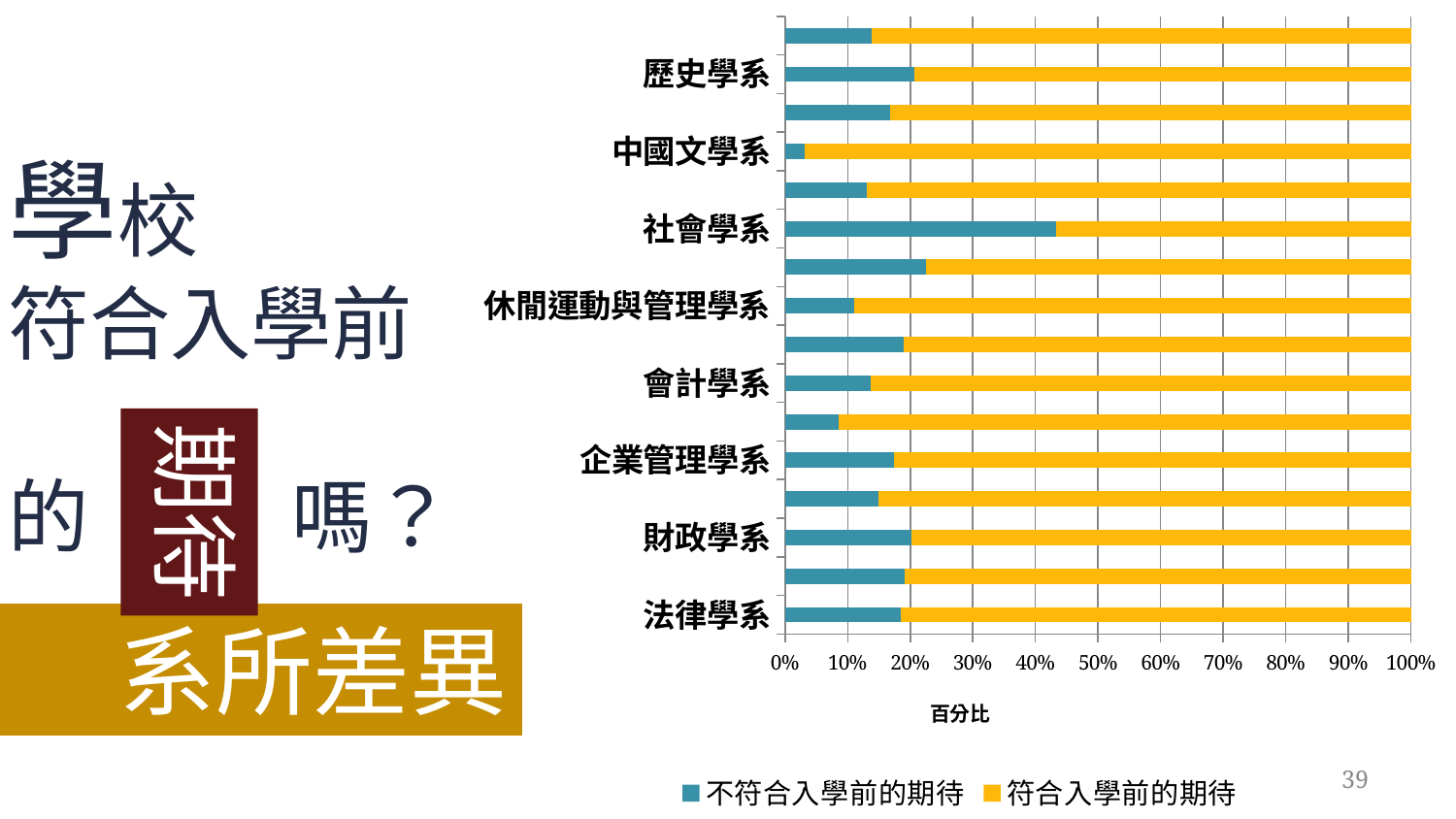
Is the 不符合入學前的期待 share for 法律學系 greater or less than 30%? less Which has a larger 不符合入學前的期待 share, 社會學系 or 中國文學系? 社會學系 Is the 不符合入學前的期待 share for 會計學系 greater or less than 10%? greater What kind of chart is shown on the slide? Stacked bar chart Which has a larger 符合入學前的期待 share, 中國文學系 or 社會學系? 中國文學系 Is the 不符合入學前的期待 share for 中國文學系 greater or less than 10%? less Which labeled department has the smallest share of 不符合入學前的期待? 中國文學系 Which labeled department has the largest share of 不符合入學前的期待? 社會學系 How many series does the legend list? 2 What are the two series named in the legend? 不符合入學前的期待 and 符合入學前的期待 What is the title of the horizontal axis? 百分比